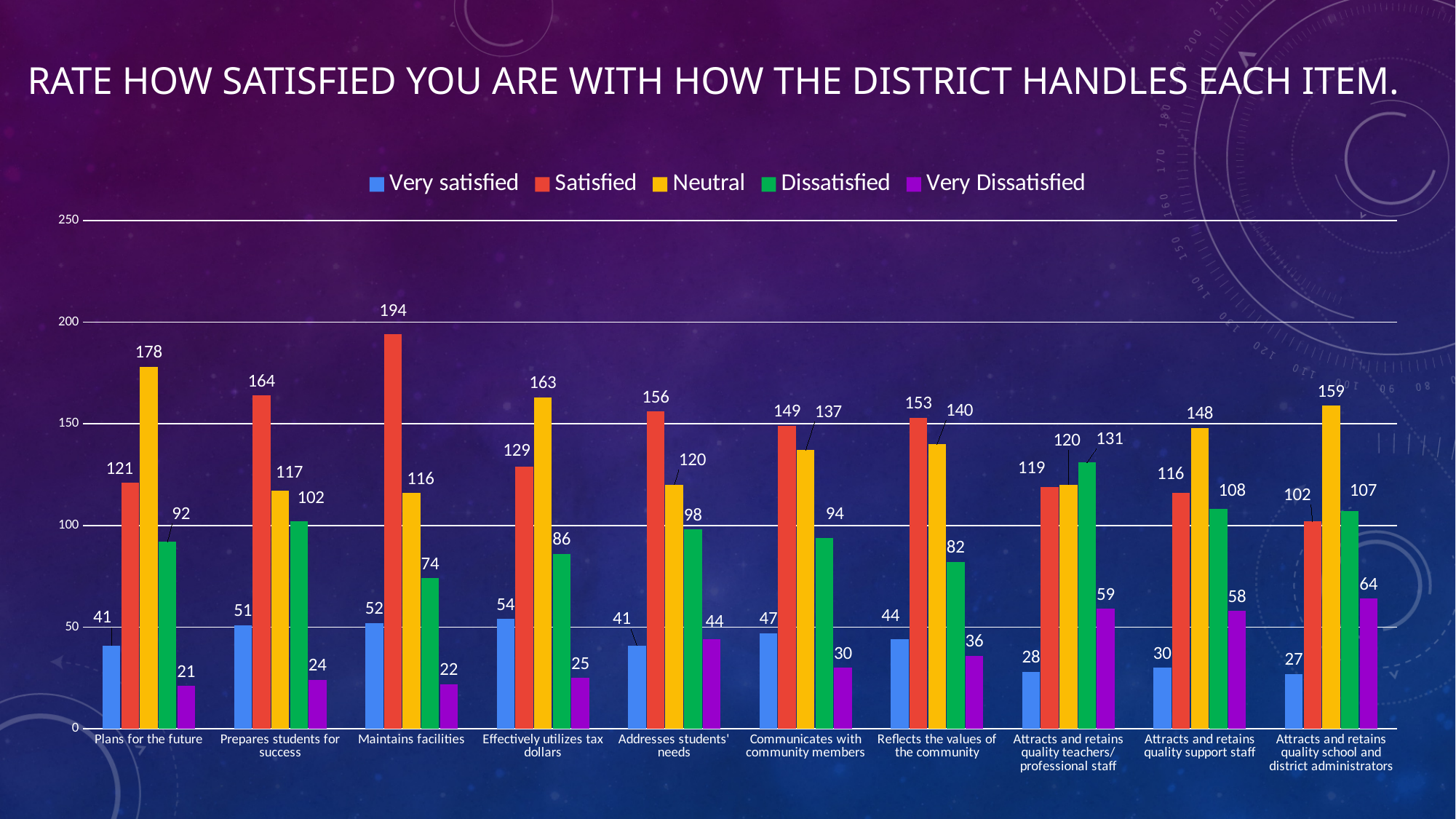
What is the Neutral value for Plans for the future? 178 What colour represents the Neutral series in the legend? yellow What is the Satisfied value for Maintains facilities? 194 How many series does the legend list? 5 How many categories are shown on the x axis? 10 Which is larger for Attracts and retains quality teachers/professional staff: the Neutral value or the Dissatisfied value? Dissatisfied What type of chart is shown on the slide? bar chart Which category has the lowest Very satisfied value? Attracts and retains quality school and district administrators Which category has the highest Very Dissatisfied value? Attracts and retains quality school and district administrators Which category has the highest Satisfied value? Maintains facilities What is the Very Dissatisfied value for Attracts and retains quality school and district administrators? 64 What is the difference between the Satisfied and Neutral values for Effectively utilizes tax dollars? 34